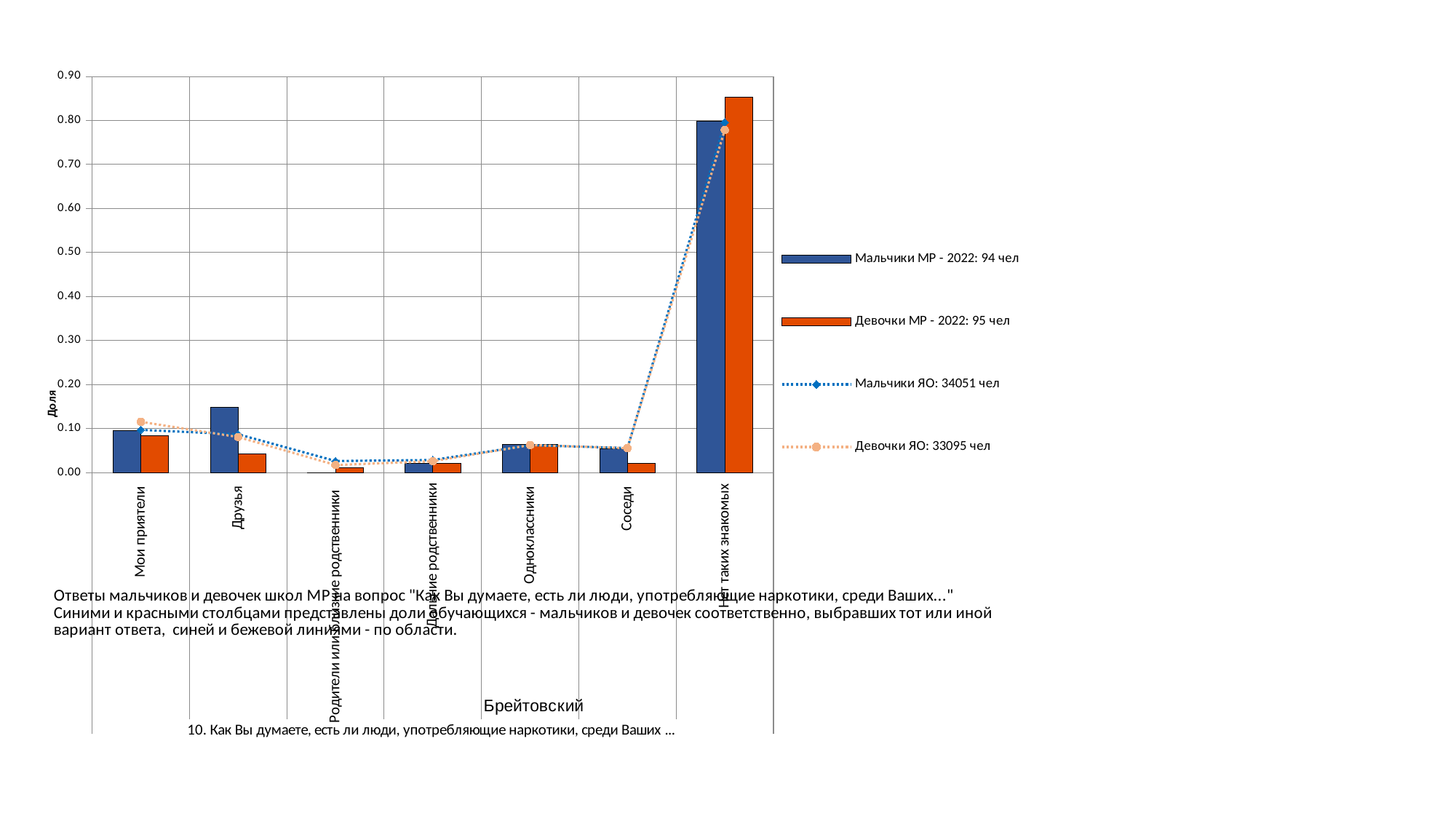
What kind of chart is shown on the slide? Combined bar and line chart What is the name of the district shown below the chart's x axis? Брейтовский In the category Нет таких знакомых, which is larger: the value for Мальчики МР - 2022 or for Девочки МР - 2022? Девочки МР - 2022 In the category Друзья, which is larger: the value for Мальчики МР - 2022 or for Девочки МР - 2022? Мальчики МР - 2022 How many categories are shown on the x axis of the chart? 7 Is the value for Мальчики МР - 2022 in the category Друзья greater or less than 0.10? greater For the series Мальчики МР - 2022, which category has the highest value? Нет таких знакомых For the series Девочки МР - 2022, which category has the highest value? Нет таких знакомых Is the value for Девочки МР - 2022 in the category Нет таких знакомых greater or less than 0.80? greater How many series does the chart's legend list? 4 For the series Мальчики МР - 2022, which category has the lowest value? Родители или близкие родственники Is the value for Девочки МР - 2022 in the category Друзья greater or less than 0.10? less